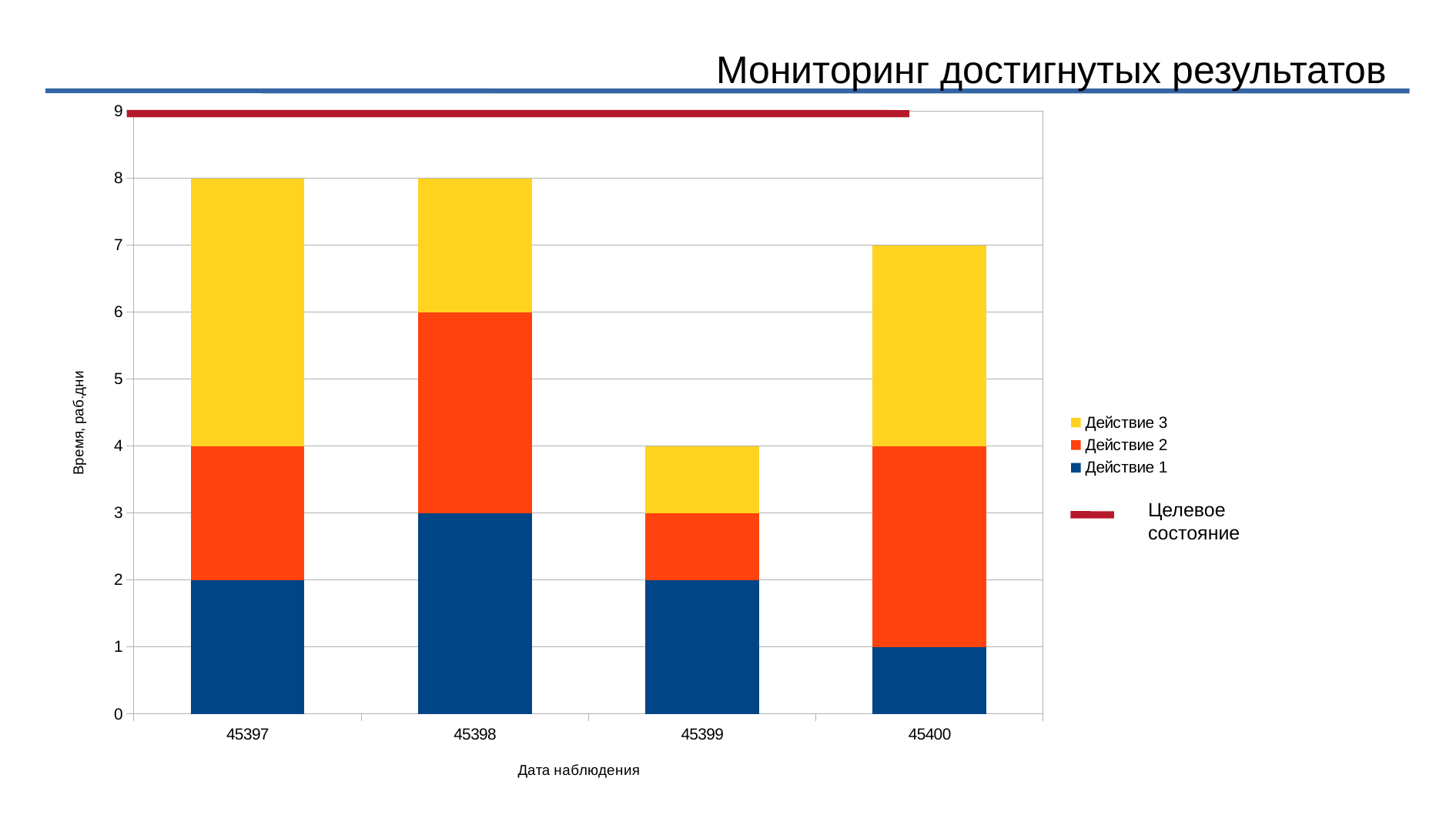
What is the total height of the stacked bar for 45399? 4 What is the label of the y axis? Время, раб.дни How many series does the chart legend list? 3 What is the difference between the total for 45398 and the total for 45400? 1 What is the value of Действие 1 for 45400? 1 What is the total height of the stacked bar for 45397? 8 How many categories are shown on the x axis? 4 Which category has the lowest total stacked bar? 45399 Which is larger, the Действие 1 value for 45398 or the Действие 1 value for 45400? 45398 Is the total for 45400 greater or less than 8? less What is the value of Действие 1 for 45398? 3 What kind of chart is shown on the slide? Stacked bar chart